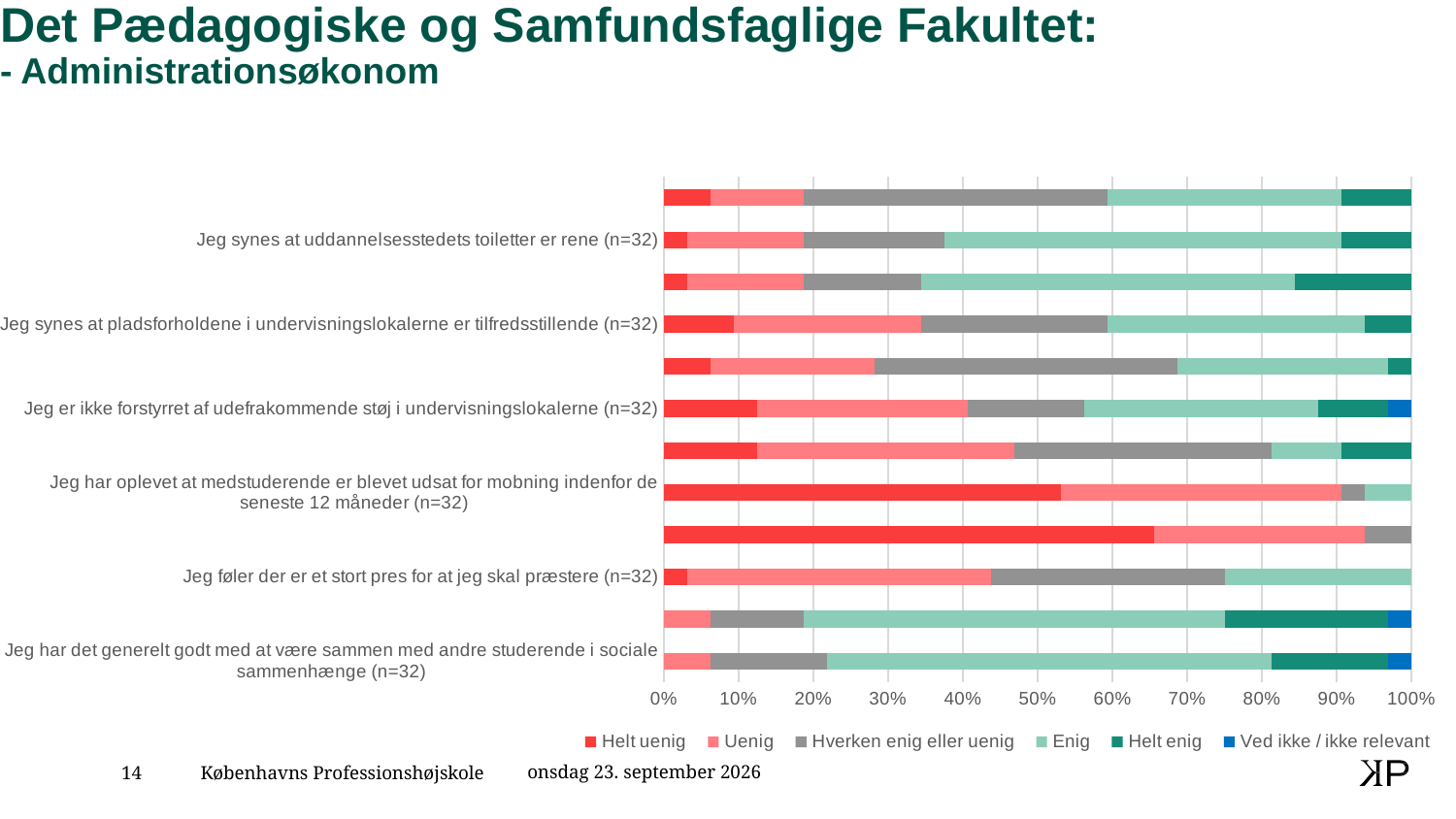
How many series does the legend list? 6 Is the 'Helt uenig' share for 'Jeg føler der er et stort pres for at jeg skal præstere (n=32)' greater or less than 10%? less Is the 'Helt uenig' share for 'Jeg har oplevet at medstuderende er blevet udsat for mobning indenfor de seneste 12 måneder (n=32)' greater or less than 50%? greater Is the 'Enig' share for 'Jeg har det generelt godt med at være sammen med andre studerende i sociale sammenhænge (n=32)' greater or less than 40%? greater What kind of chart is shown on the slide? Stacked bar chart Which has the larger 'Helt uenig' share: 'Jeg er ikke forstyrret af udefrakommende støj i undervisningslokalerne (n=32)' or 'Jeg synes at uddannelsesstedets toiletter er rene (n=32)'? Jeg er ikke forstyrret af udefrakommende støj i undervisningslokalerne (n=32) Which has the larger 'Helt uenig' share: 'Jeg har oplevet at medstuderende er blevet udsat for mobning indenfor de seneste 12 måneder (n=32)' or 'Jeg føler der er et stort pres for at jeg skal præstere (n=32)'? Jeg har oplevet at medstuderende er blevet udsat for mobning indenfor de seneste 12 måneder (n=32) What is the first entry in the chart's legend? Helt uenig What is the last entry in the chart's legend? Ved ikke / ikke relevant How many stacked bars are plotted in the chart? 12 What is the maximum value shown on the x axis? 100%